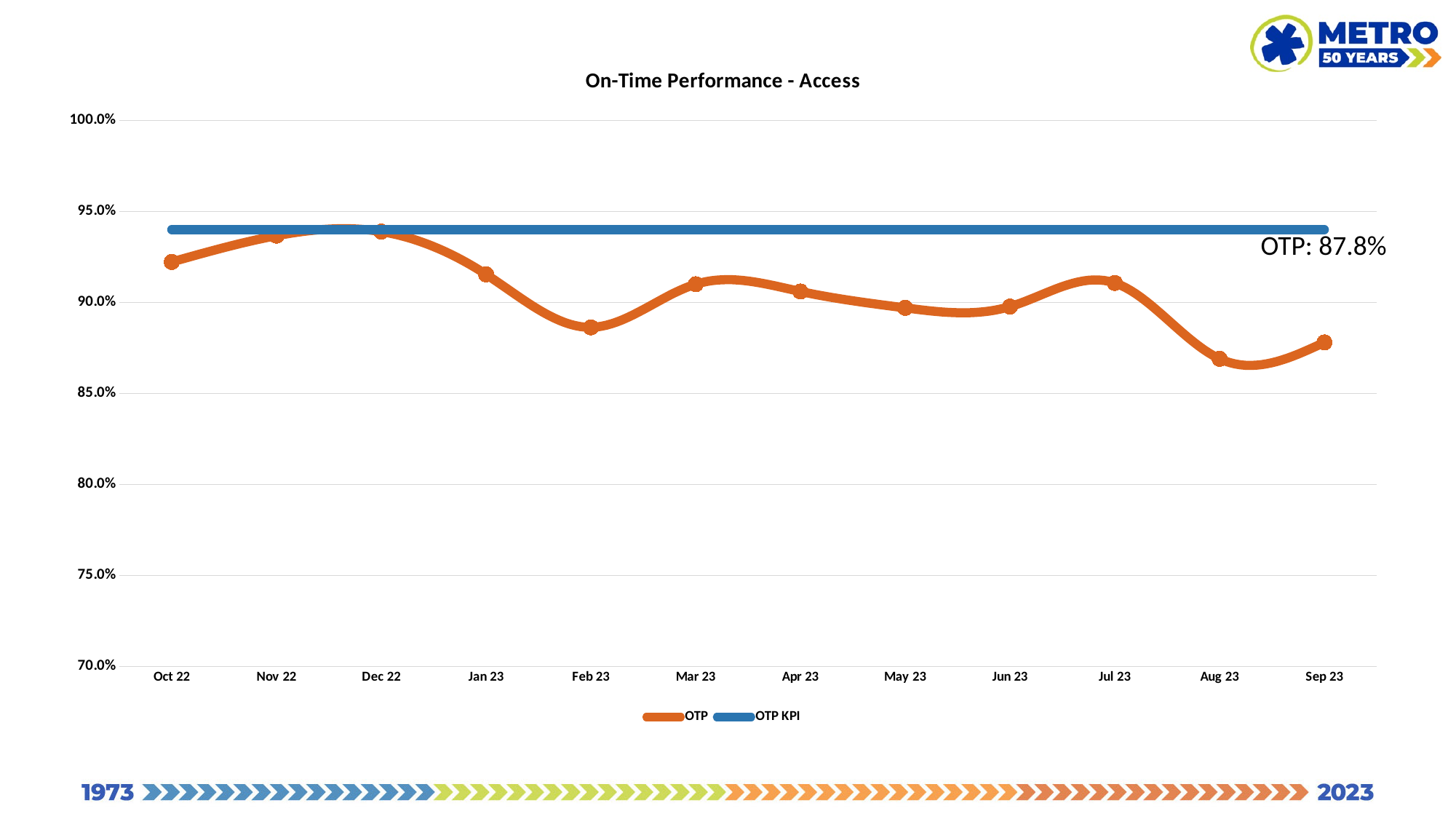
Which month has the lowest OTP value? Aug 23 What is the title of the chart? On-Time Performance - Access What kind of chart is shown on the slide? line chart How many months are plotted along the x axis? 12 How many series does the legend list? 2 Is the OTP value for Aug 23 greater or less than 85.0%? greater Is the OTP value for Feb 23 greater or less than 90.0%? less Does the OTP line rise or fall from Jul 23 to Aug 23? fall What OTP value is annotated on the chart for the latest month, Sep 23? 87.8% Is the OTP value for Oct 22 greater or less than 90.0%? greater Which is larger, the OTP value for Jul 23 or for Aug 23? Jul 23 What are the two entries in the legend? OTP and OTP KPI